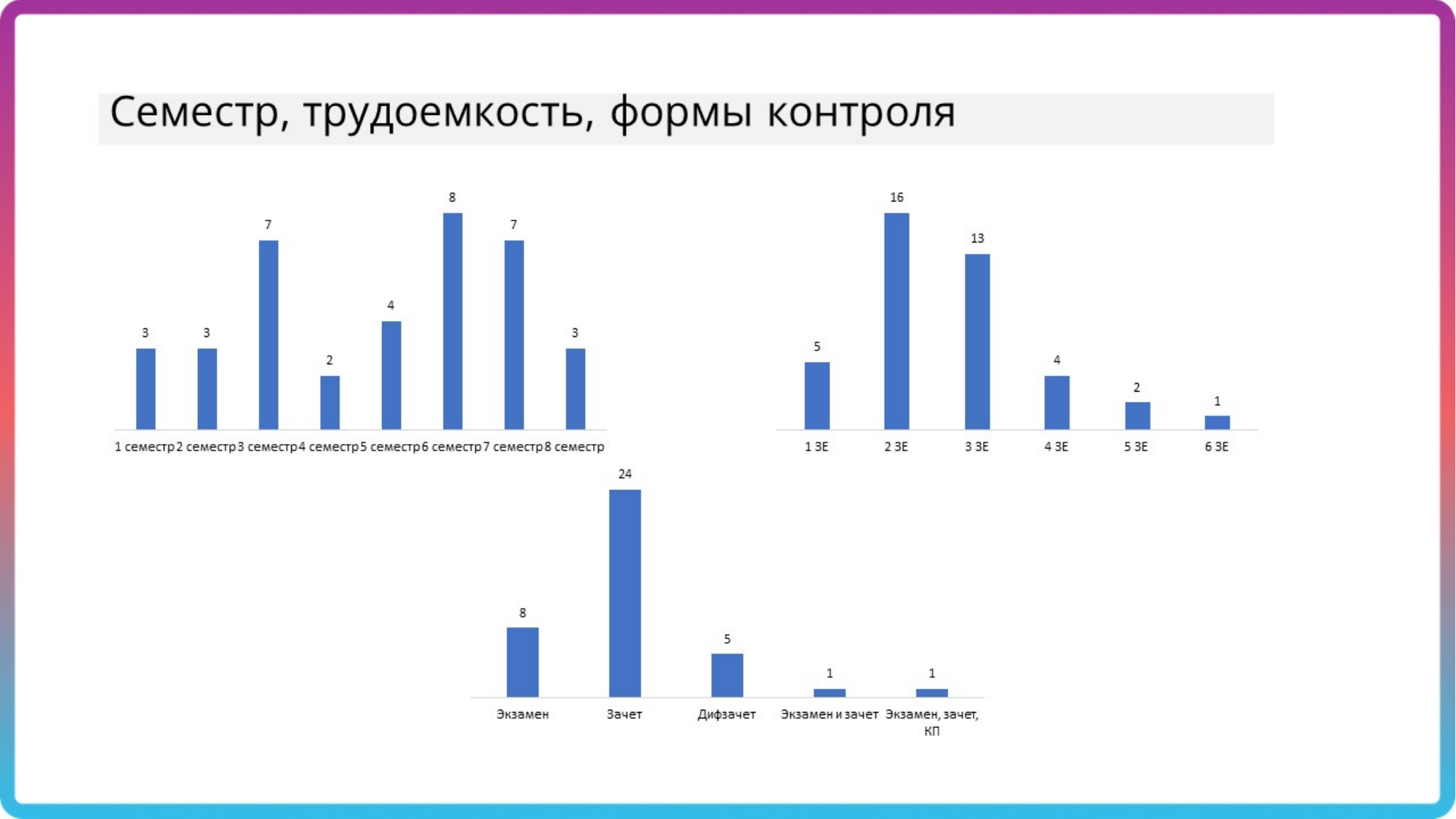
In the top-left chart (semesters), which semester has the highest value? 6 семестр In the top-left chart (semesters), which semester has the lowest value? 4 семестр In the bottom chart (forms of control), what is the value for Зачет? 24 What type of chart is the bottom chart (forms of control)? bar chart In the top-left chart (semesters), what is the value for 6 семестр? 8 In the top-right chart (ЗЕ), what is the difference between the values for 2 ЗЕ and 3 ЗЕ? 3 In the top-right chart (ЗЕ), do the values rise or fall from 3 ЗЕ to 6 ЗЕ? fall In the top-left chart (semesters), how many categories are shown on the x axis? 8 In the bottom chart (forms of control), how many categories are shown? 5 In the top-right chart (ЗЕ), what is the value for 2 ЗЕ? 16 In the top-right chart (ЗЕ), which category has the lowest value? 6 ЗЕ In the bottom chart (forms of control), which is larger, Экзамен or Дифзачет? Экзамен